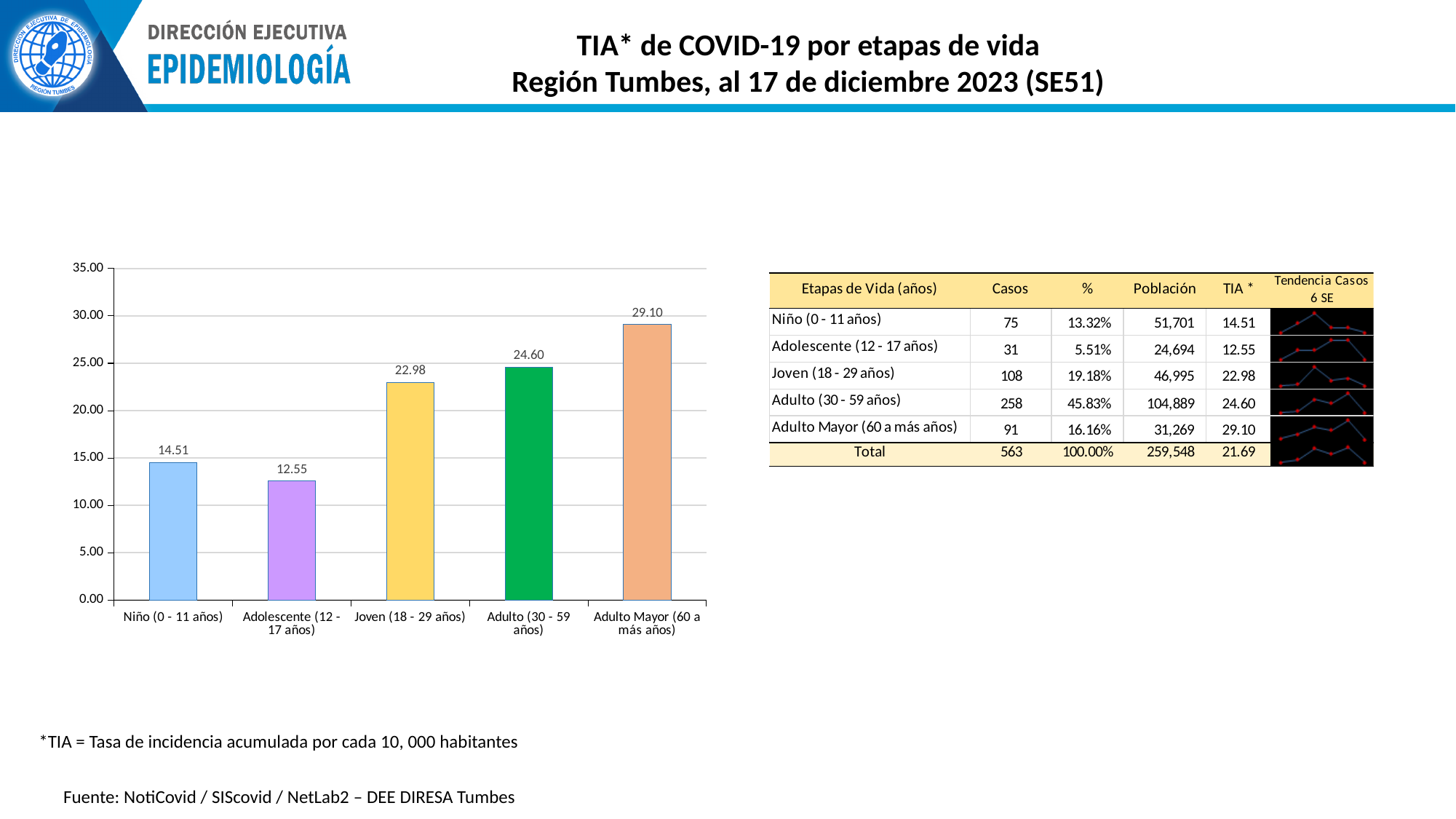
What is the TIA value for Joven (18 - 29 años) in the bar chart? 22.98 What kind of chart is used to show TIA by life stage? Bar chart Which life stage has the lowest TIA in the bar chart? Adolescente (12 - 17 años) Which has a larger TIA, Joven (18 - 29 años) or Adulto (30 - 59 años)? Adulto (30 - 59 años) What is the difference between the TIA for Adulto Mayor (60 a más años) and Niño (0 - 11 años)? 14.59 What is the TIA value for Adulto (30 - 59 años) in the bar chart? 24.60 What is the TIA value for Adolescente (12 - 17 años) in the bar chart? 12.55 What colour is the bar for Adulto (30 - 59 años)? Green Is the TIA value for Adulto Mayor (60 a más años) greater or less than 25.00? greater How many life-stage categories are shown in the bar chart? 5 Which life stage has the highest TIA in the bar chart? Adulto Mayor (60 a más años) What is the TIA value for Niño (0 - 11 años) in the bar chart? 14.51